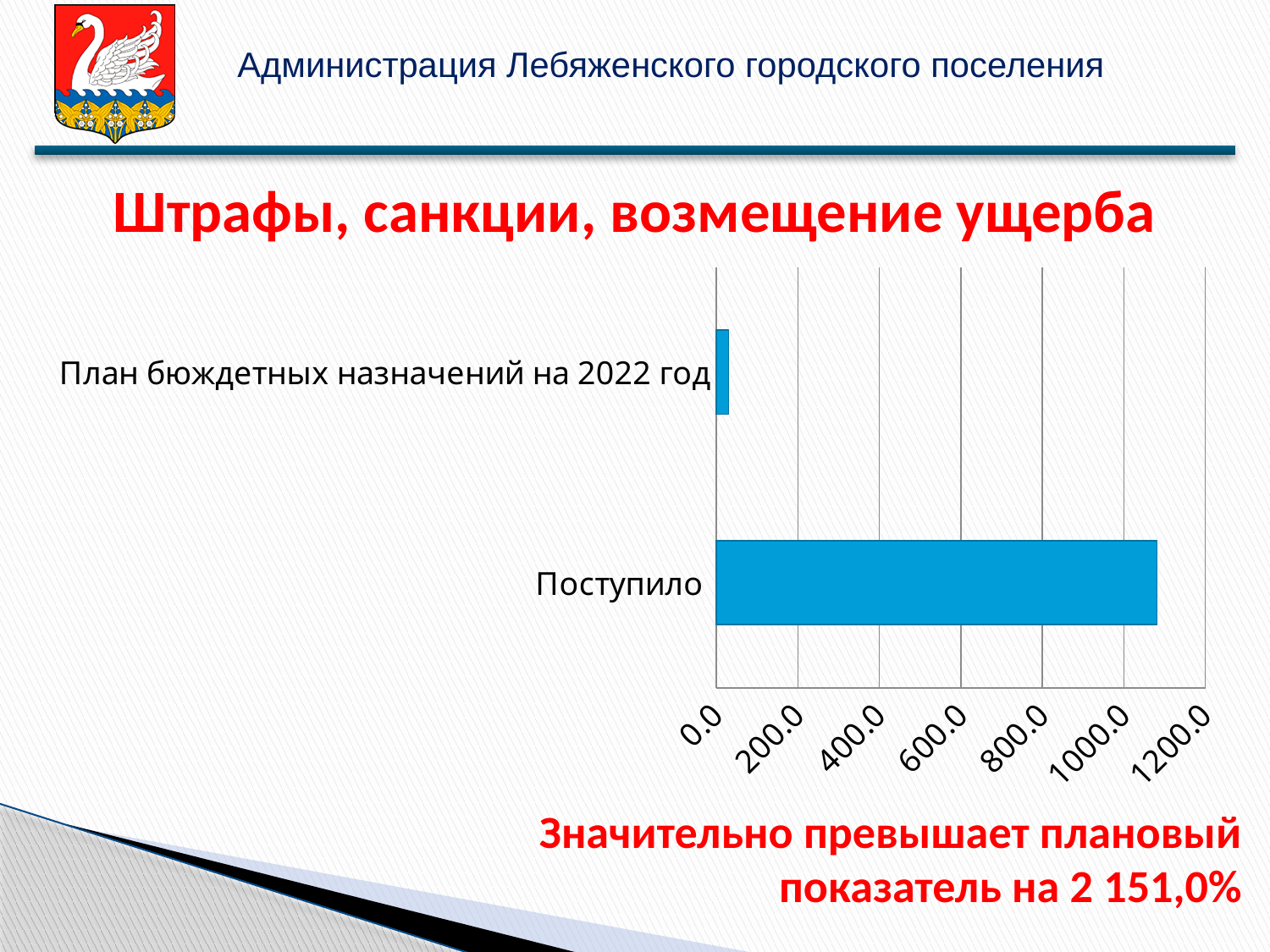
How many categories are plotted in the chart? 2 What is the title of the chart on the slide? Штрафы, санкции, возмещение ущерба Is the value for Поступило greater or less than 1000.0? greater What is the highest tick value shown on the horizontal axis of the chart? 1200.0 Which category has the highest value in the chart? Поступило Which category has the lowest value in the chart? План бюждетных назначений на 2022 год Which is larger: the value for Поступило or the value for План бюждетных назначений на 2022 год? Поступило Is the value for План бюждетных назначений на 2022 год greater or less than 200.0? less Is the value for Поступило greater or less than 1200.0? less What kind of chart is shown on the slide? bar chart